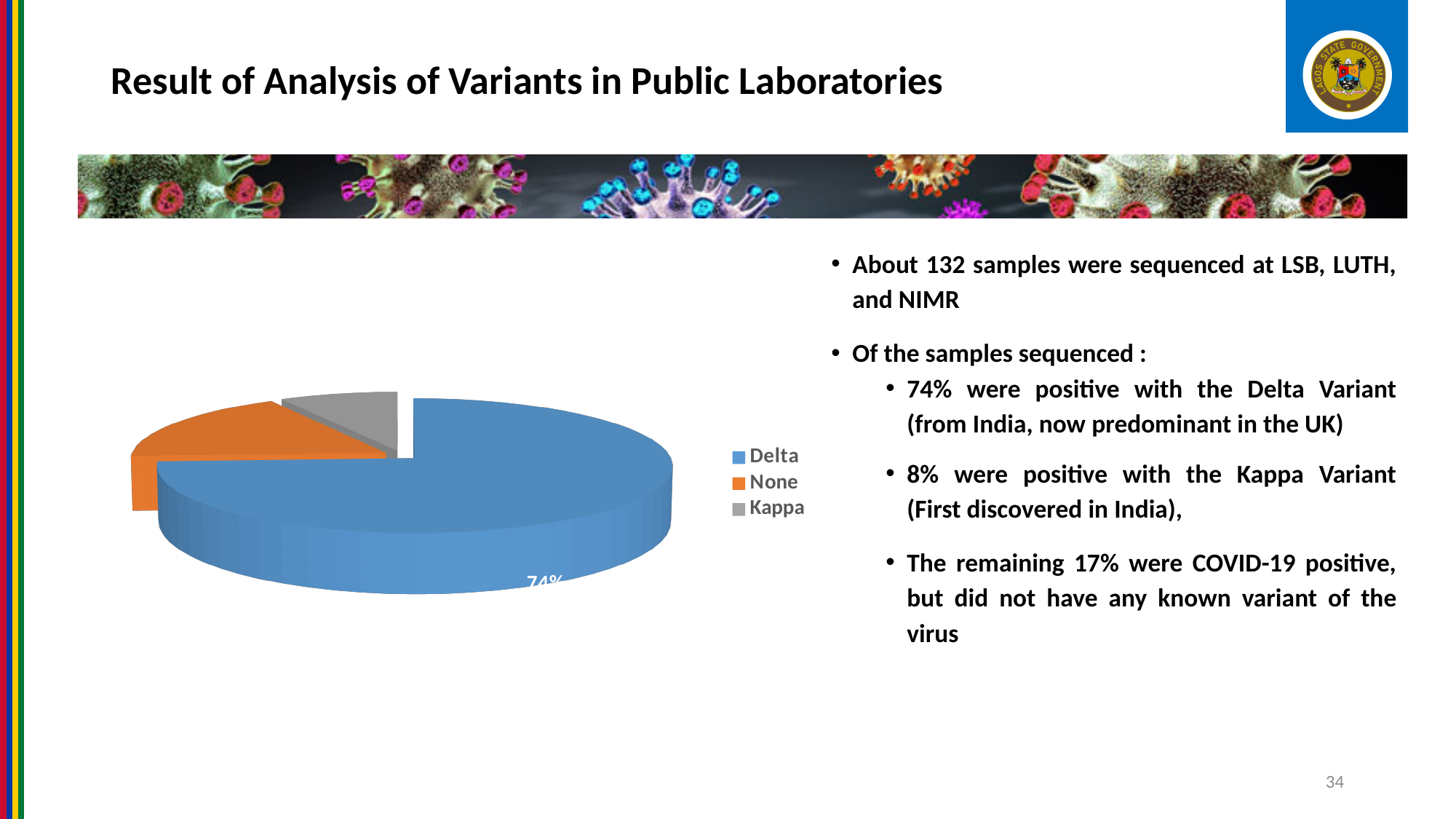
Which slice is larger, None or Kappa? None What share of samples were positive with the Kappa variant, according to the slide? 8% What entries are listed in the pie chart's legend? Delta, None, Kappa What is the difference in percentage points between the Delta share and the Kappa share? 66% What kind of chart is shown on the slide? pie chart What colour is the Delta slice in the pie chart? blue What share of the pie does the Delta slice represent? 74% Which category has the largest slice of the pie chart? Delta Which category has the smallest slice of the pie chart? Kappa What share of samples had no known variant (None), according to the slide? 17% How many slices does the pie chart have? 3